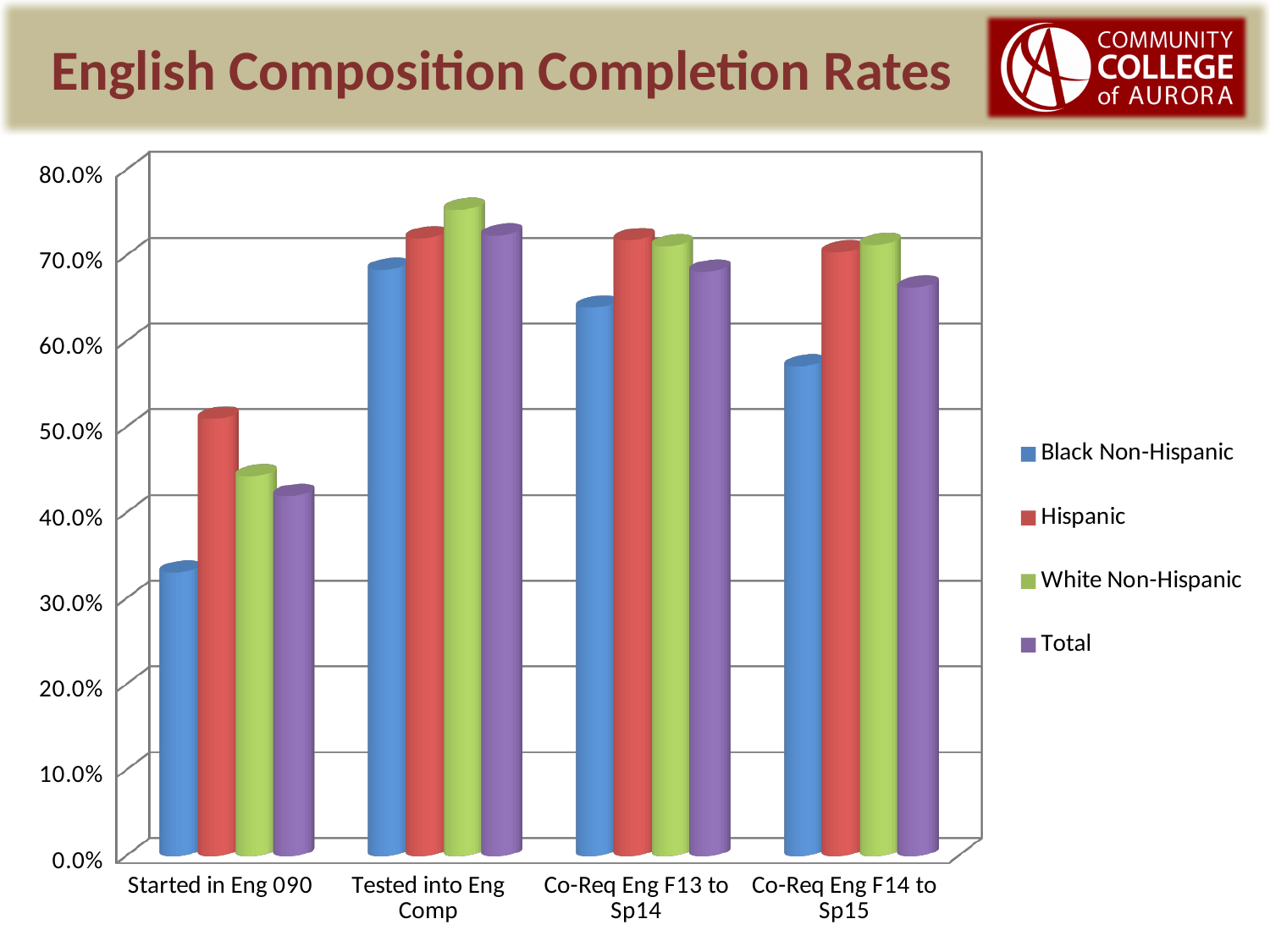
Which series has the highest value in the Tested into Eng Comp category? White Non-Hispanic Is the Hispanic value for Started in Eng 090 greater or less than 40.0%? greater Which series has the highest value in the Started in Eng 090 category? Hispanic Is the Black Non-Hispanic value for Started in Eng 090 greater or less than 40.0%? less Is the Total value for Co-Req Eng F14 to Sp15 greater or less than 60.0%? greater How many series does the chart's legend list? 4 For which category is the Black Non-Hispanic value lowest? Started in Eng 090 What colour represents the Total series in the chart? purple Which is larger: the Black Non-Hispanic value for Co-Req Eng F13 to Sp14 or for Co-Req Eng F14 to Sp15? Co-Req Eng F13 to Sp14 How many categories are shown on the x axis of the chart? 4 From Tested into Eng Comp through Co-Req Eng F14 to Sp15, do the Black Non-Hispanic values rise or fall? fall What kind of chart is shown on the slide? bar chart